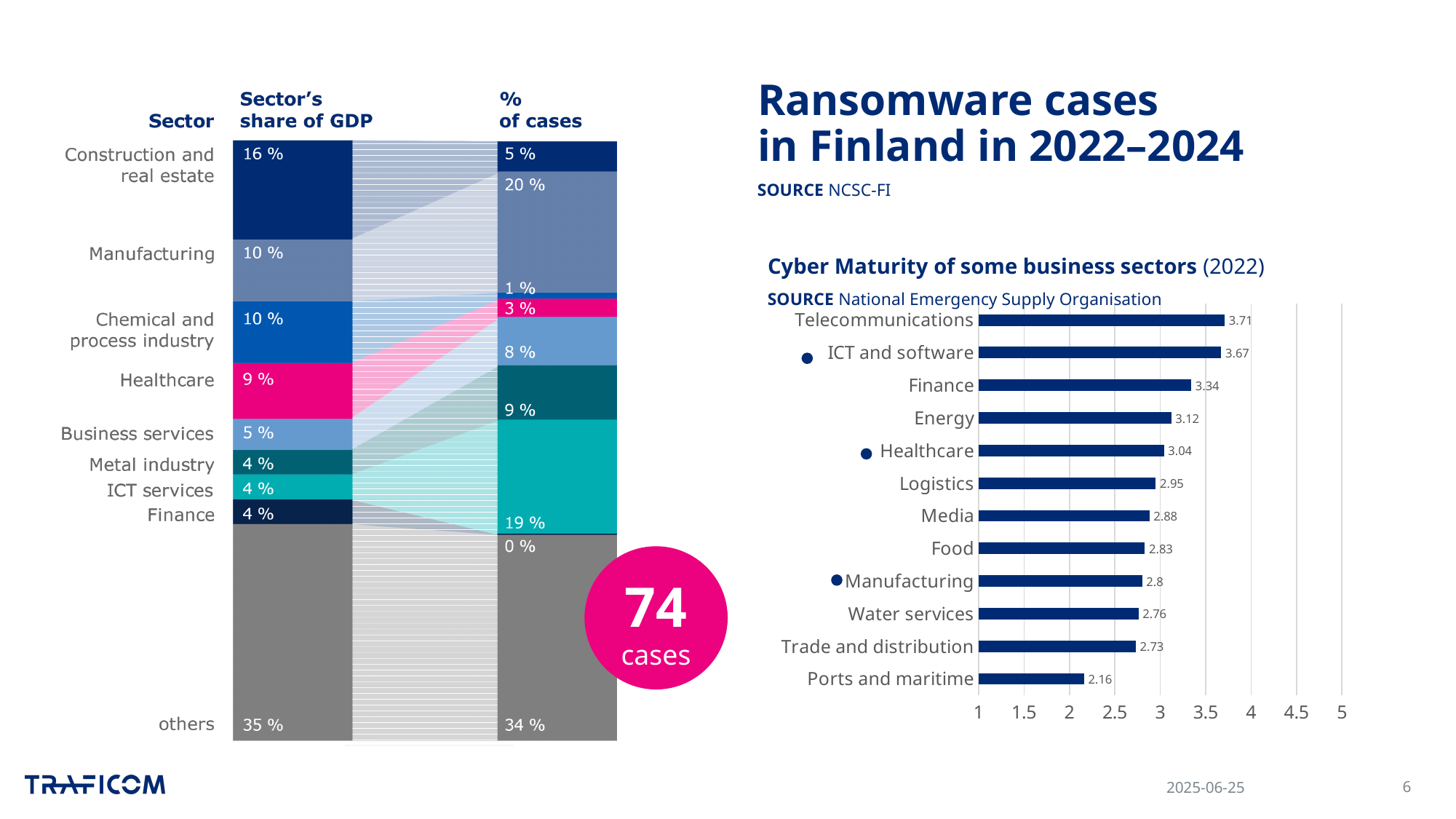
In the Cyber Maturity of some business sectors chart, how many sectors are shown? 12 In the left chart, what is the % of cases for the 'others' category? 34 % What kind of chart is the Cyber Maturity of some business sectors chart? Bar chart In the Cyber Maturity of some business sectors chart, what is the value for Ports and maritime? 2.16 In the left chart, what is the sector's share of GDP for Construction and real estate? 16 % In the Cyber Maturity of some business sectors chart, which has a higher value, Logistics or Media? Logistics In the Cyber Maturity of some business sectors chart, what is the difference between the values for Finance and Energy? 0.22 In the Cyber Maturity of some business sectors chart, which sector has the lowest value? Ports and maritime In the left chart, what is the difference between the sector's share of GDP for Manufacturing and for Business services? 5 % In the Cyber Maturity of some business sectors chart, which sector has the highest value? Telecommunications In the Cyber Maturity of some business sectors chart, what is the value for Telecommunications? 3.71 In the left chart, what is the sector's share of GDP for Healthcare? 9 %